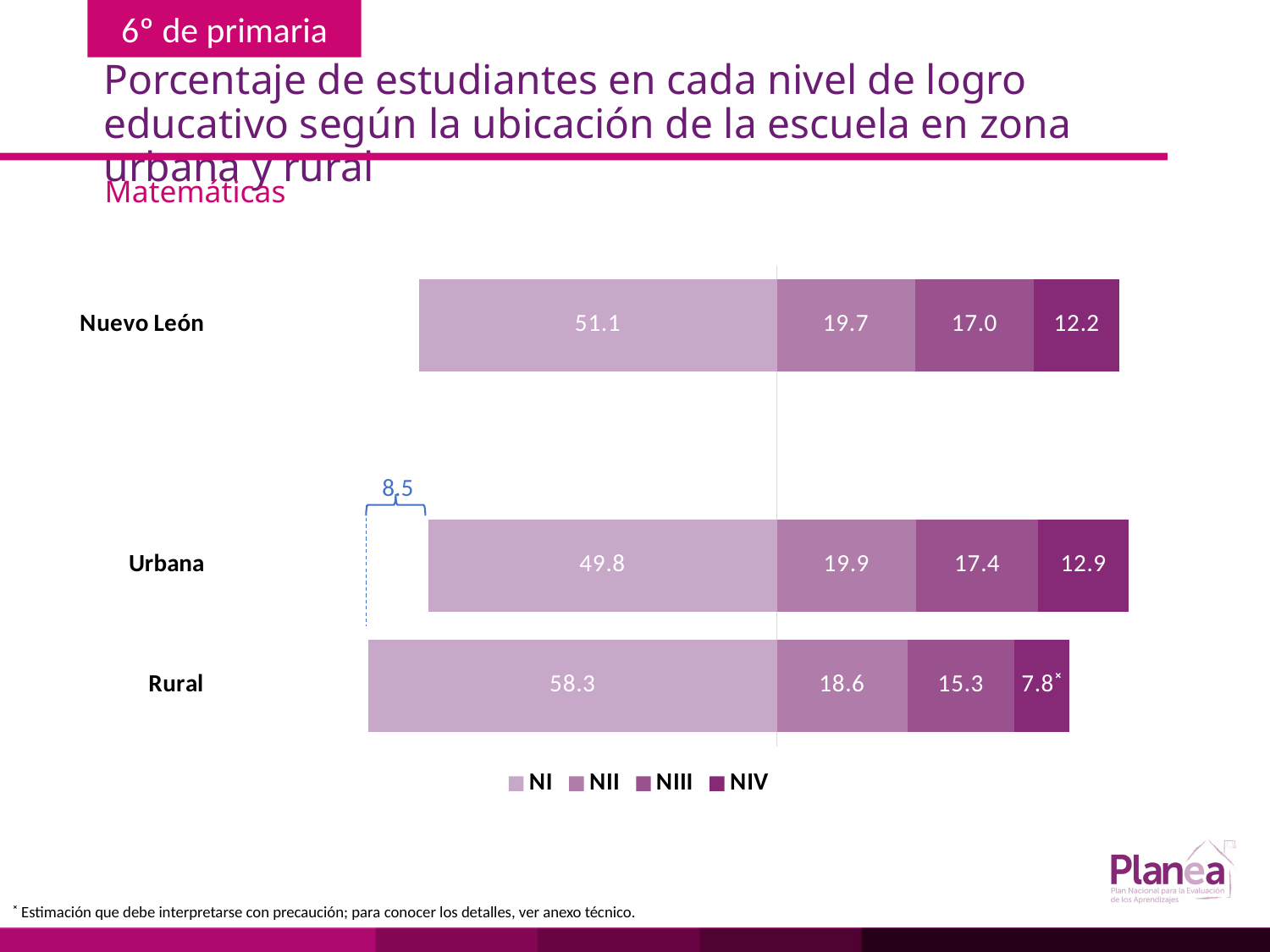
Which category has the lowest NIV value? Rural What percentage of Rural students are at level NI? 58.3 What kind of chart is shown on the slide? Stacked bar chart What is the NIII value for Rural? 15.3 What is the total of the Nuevo León stacked bar? 100.0 Which category has the highest NI value? Rural What is the value for NIV in the Urbana bar? 12.9 Which is larger, the NIII value for Urbana or for Nuevo León? Urbana How many categories (bars) are shown in the chart? 3 What is the NII value for Nuevo León? 19.7 How many series does the legend list? 4 What is the difference between the NI values for Rural and Urbana? 8.5